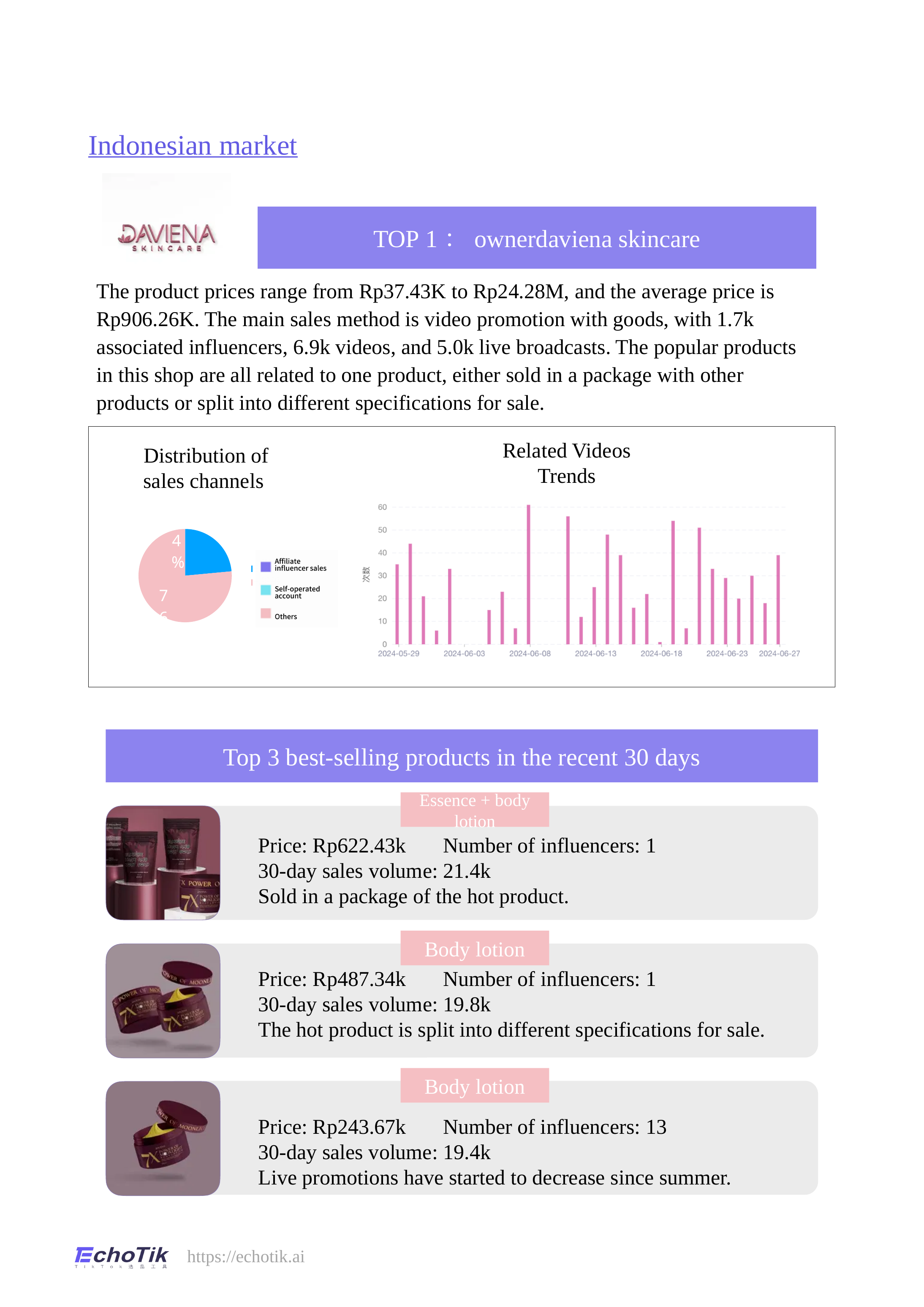
In the "Distribution of sales channels" chart, how many entries does the legend list? 3 In the "Related Videos Trends" chart, which date has the tallest bar? 2024-06-08 In the "Related Videos Trends" chart, which is larger, the value for 2024-06-08 or the value for 2024-06-03? 2024-06-08 What is the first date shown on the x axis of the "Related Videos Trends" chart? 2024-05-29 What kind of chart is the "Distribution of sales channels" chart? pie chart In the "Related Videos Trends" chart, is the value for 2024-05-29 greater or less than 30? greater In the "Related Videos Trends" chart, is the value for 2024-06-08 greater or less than 50? greater In the "Related Videos Trends" chart, is the value for 2024-06-13 greater or less than 40? less What kind of chart is the "Related Videos Trends" chart? bar chart In the "Distribution of sales channels" chart, which colour represents the "Others" slice? pink In the "Distribution of sales channels" chart, which sales channel has the largest slice? Others